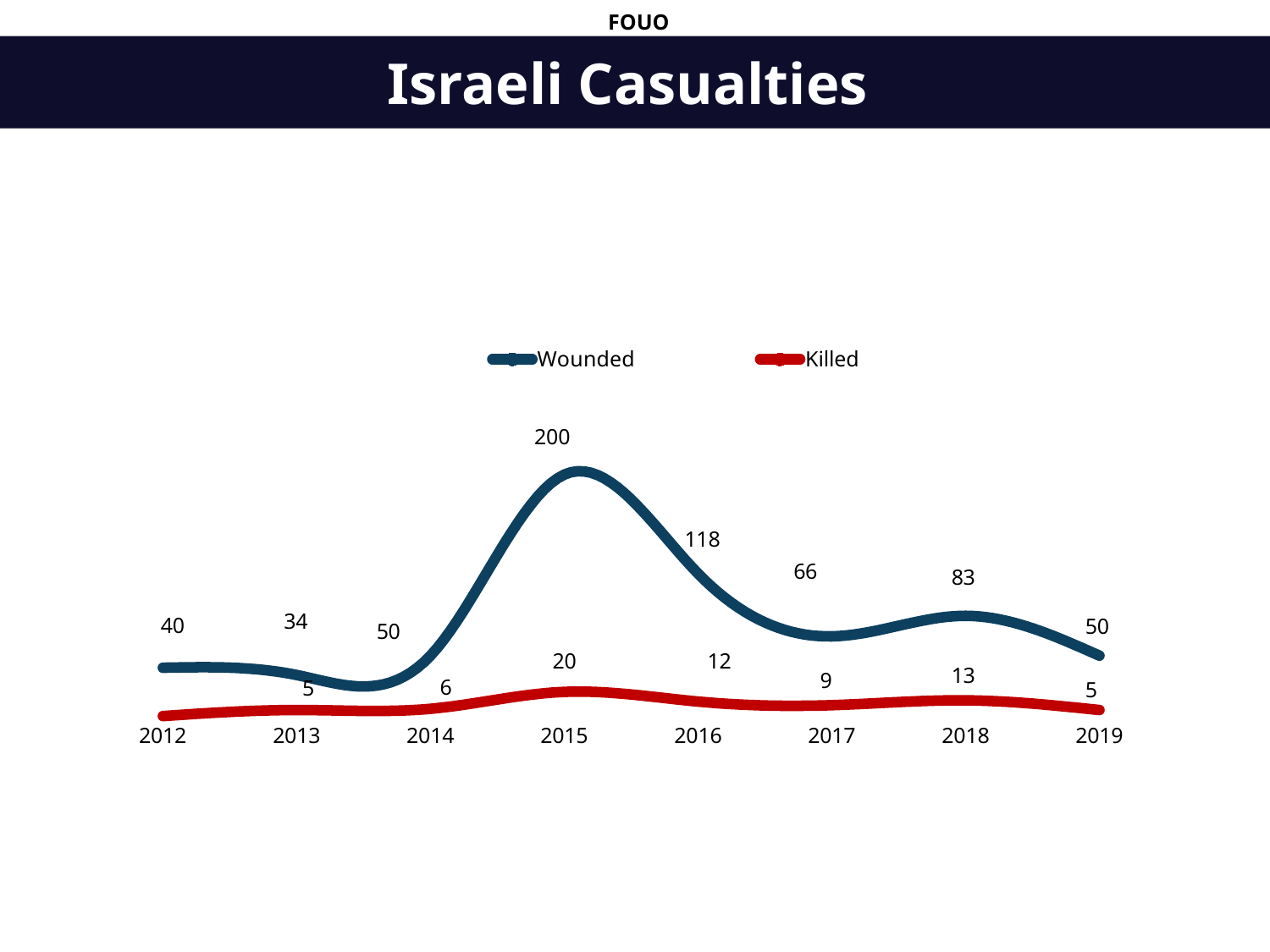
Does the Wounded value rise or fall from 2018 to 2019? Fall What is the Killed value for 2016? 12 How many years are shown on the x axis? 8 What is the title of the chart? Israeli Casualties What is the Wounded value for 2018? 83 Which is larger, the Wounded value for 2017 or for 2018? 2018 What is the difference between the Wounded values for 2015 and 2016? 82 In which year is the Wounded value lowest? 2013 What type of chart is shown on the slide? Line chart How many series does the legend list? 2 What is the Wounded value for 2015? 200 In which year is the Wounded value highest? 2015